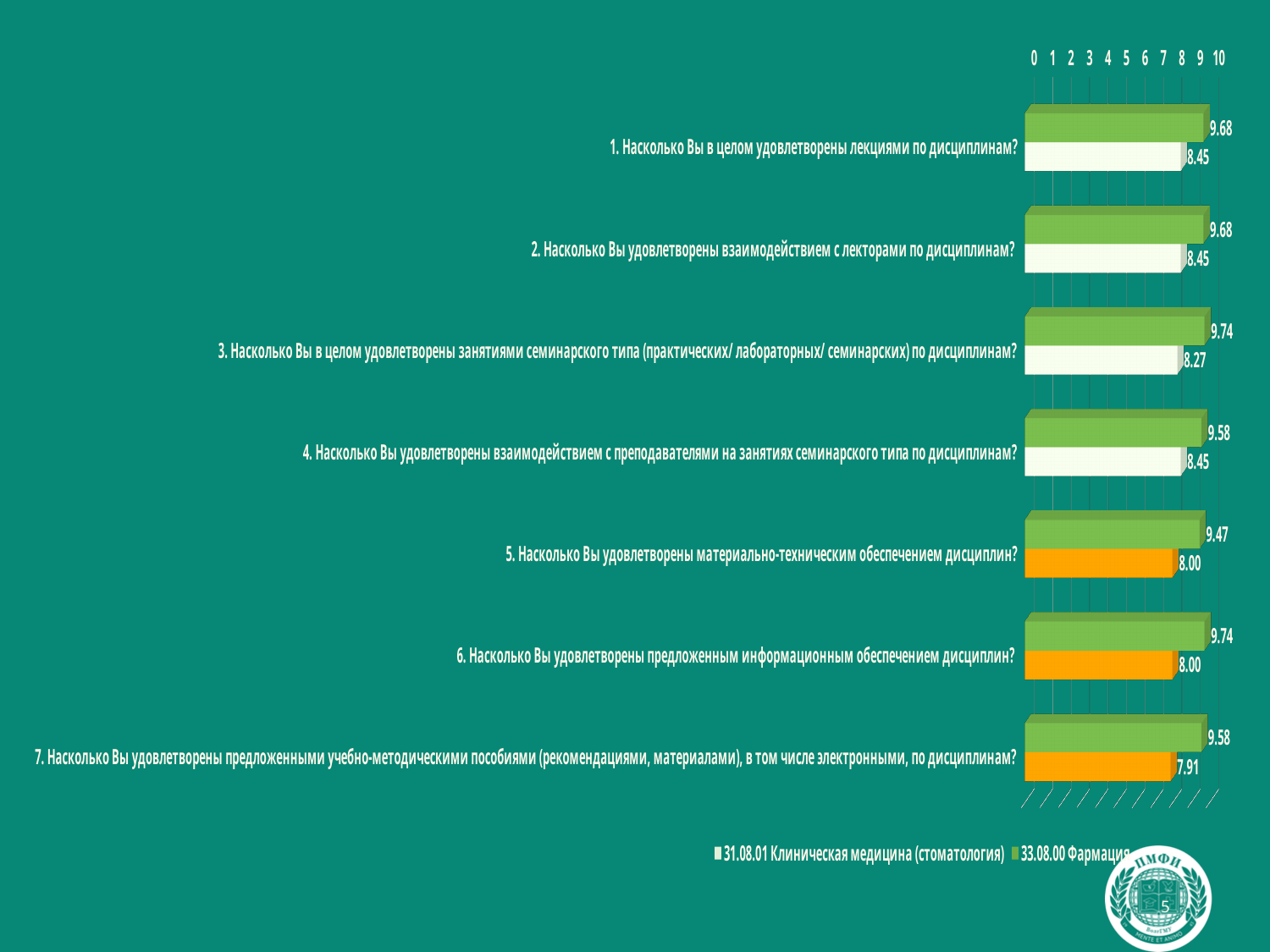
Which question has the lowest value for the 33.08.00 Фармация series? 5. Насколько Вы удовлетворены материально-техническим обеспечением дисциплин? Is the value for 31.08.01 Клиническая медицина (стоматология) on question 2 greater or less than 9? less What type of chart is shown on the slide? bar chart What is the value for 33.08.00 Фармация on question 5 (материально-техническим обеспечением дисциплин)? 9.47 How many survey questions (categories) are plotted on the chart? 7 What is the value of the lower bar for question 7 (учебно-методическими пособиями)? 7.91 On question 6 (информационным обеспечением дисциплин), which series has the larger value? 33.08.00 Фармация What is the value for 33.08.00 Фармация on question 1 (удовлетворены лекциями по дисциплинам)? 9.68 What colour are the bars for the 33.08.00 Фармация series? green What is the difference between the two series' values on question 4 (взаимодействием с преподавателями на занятиях семинарского типа)? 1.13 What is the value for 31.08.01 Клиническая медицина (стоматология) on question 3 (занятиями семинарского типа)? 8.27 How many series does the legend list? 2